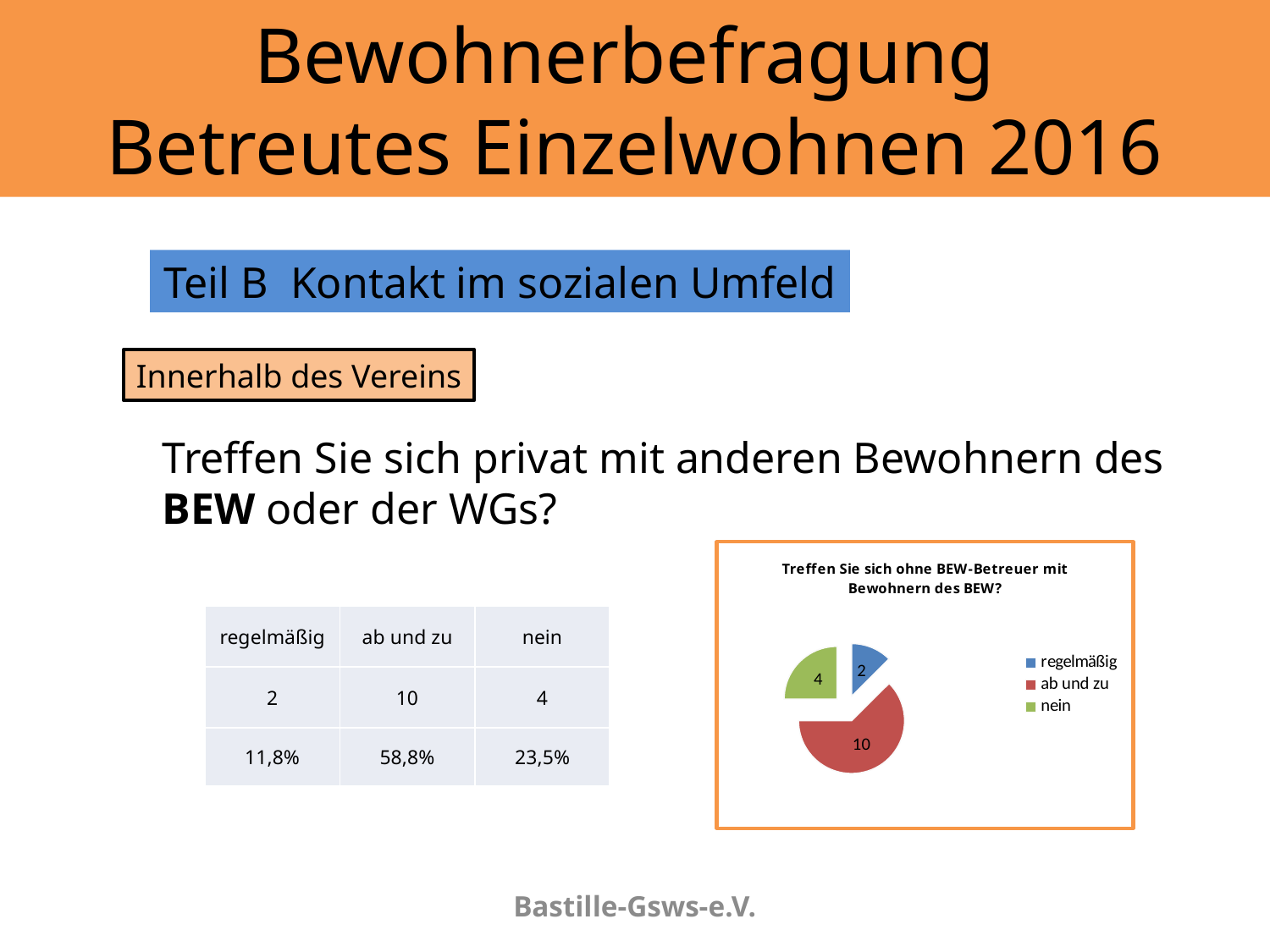
What is the title of the pie chart? Treffen Sie sich ohne BEW-Betreuer mit Bewohnern des BEW? What value is shown for the slice "regelmäßig" in the pie chart? 2 How many entries does the legend of the pie chart list? 3 What colour is the "ab und zu" slice in the pie chart? red Which slice is larger in the pie chart, "nein" or "regelmäßig"? nein Which category has the smallest slice in the pie chart? regelmäßig What kind of chart is shown on the slide? pie chart What value is shown for the slice "nein" in the pie chart? 4 How many slices does the pie chart have? 3 Which category has the largest slice in the pie chart? ab und zu What is the difference between the values for "ab und zu" and "nein" in the pie chart? 6 What value is shown for the slice "ab und zu" in the pie chart? 10